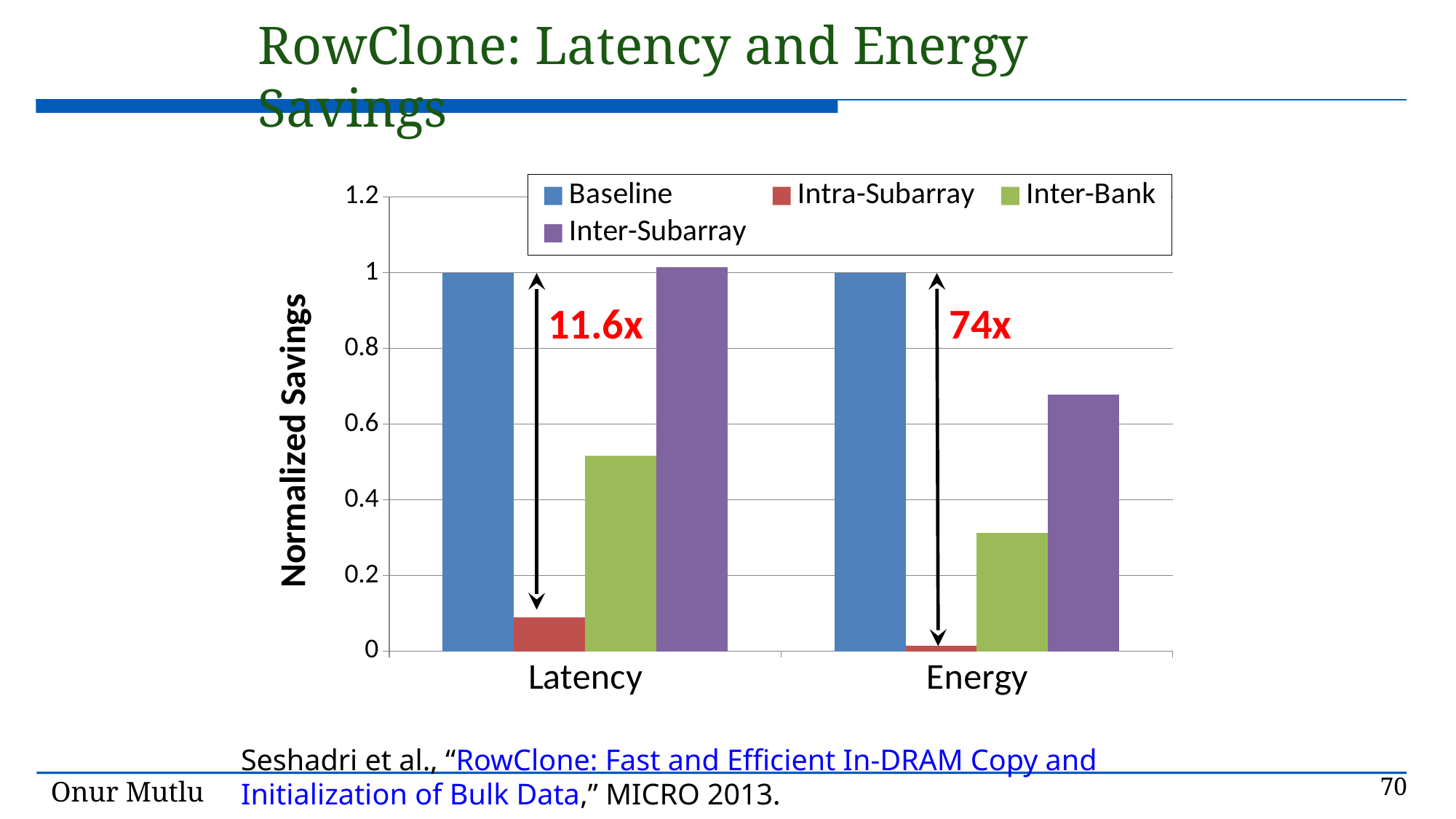
Which series has the lowest value for Energy? Intra-Subarray What kind of chart is shown on the slide? bar chart Is the Inter-Bank value for Energy greater or less than 0.4? less What improvement factor is annotated between the Baseline and Intra-Subarray bars for Energy? 74x Is the Intra-Subarray value for Latency greater or less than 0.2? less How many series does the legend list? 4 Is the Inter-Bank value for Latency greater or less than 0.4? greater How many categories are shown on the x axis? 2 What is the Baseline value for Latency? 1 What is the title of the y axis? Normalized Savings Which is larger, the Inter-Bank value for Latency or the Inter-Bank value for Energy? Latency